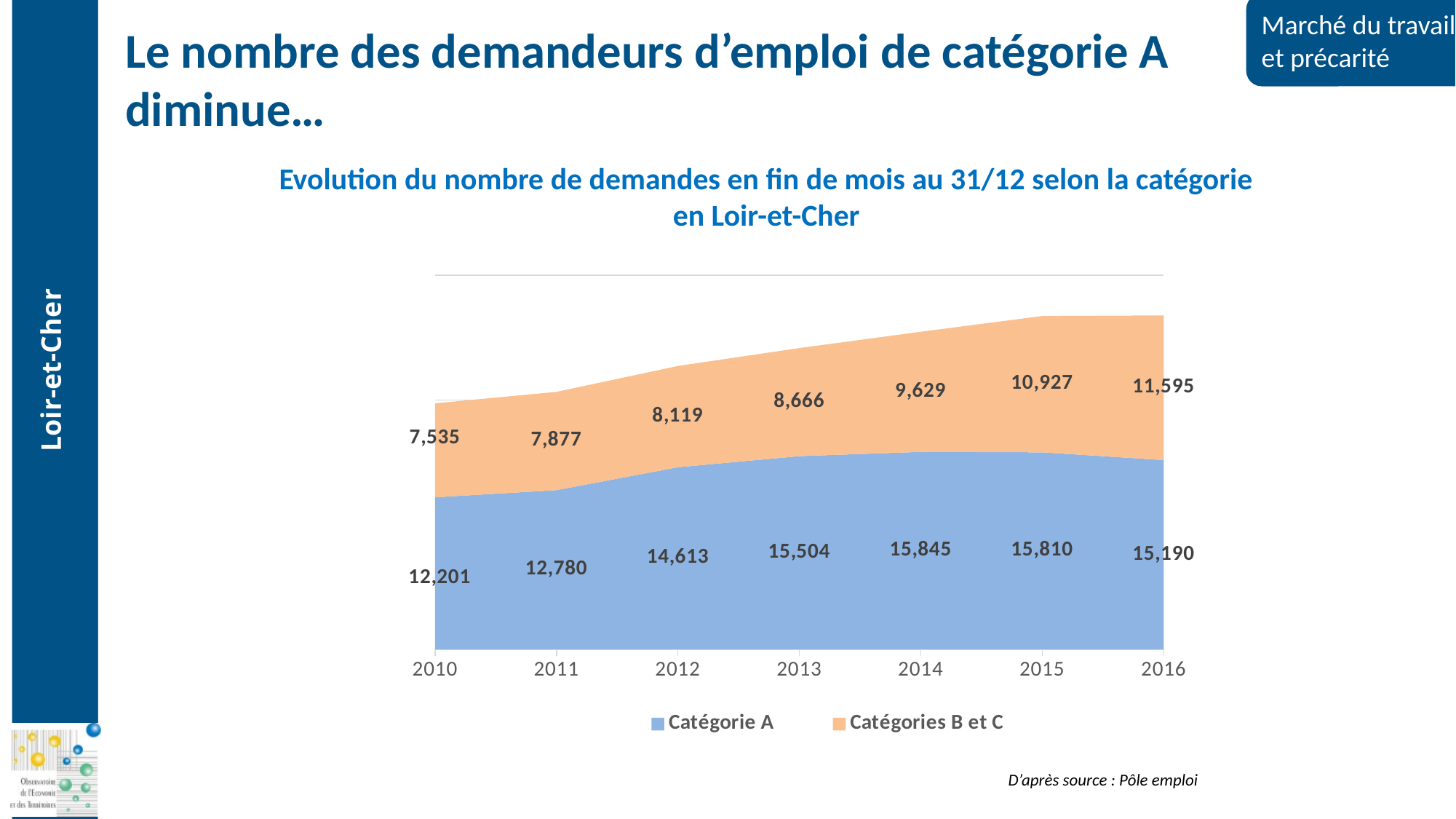
What is the total of Catégorie A and Catégories B et C in 2016? 26,785 In which year is the value for Catégorie A the highest? 2014 Do the values for Catégories B et C rise or fall from 2010 to 2016? Rise Which is larger: the Catégories B et C value in 2013 or in 2012? 2013 What is the value for Catégorie A in 2014? 15,845 What is the difference between the Catégorie A values for 2016 and 2015? 620 How many series does the legend list? 2 What kind of chart is shown? Stacked area chart What is the value for Catégories B et C in 2016? 11,595 What is the value for Catégorie A in 2010? 12,201 How many years are shown on the x axis? 7 In which year is the value for Catégories B et C the lowest? 2010